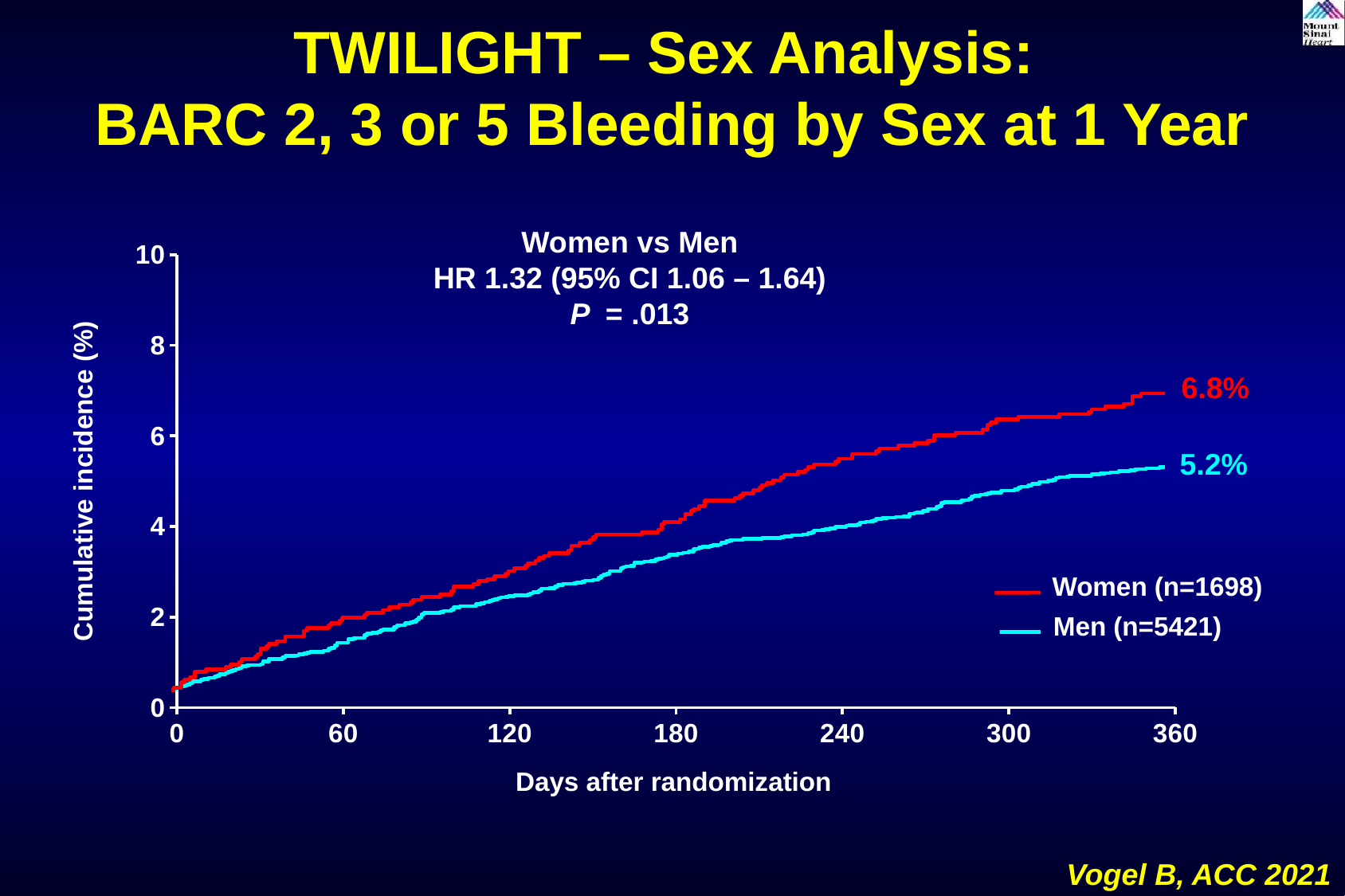
What is the cumulative incidence of BARC 2, 3 or 5 bleeding for Women at 1 year? 6.8% What kind of chart is shown on the slide? Line chart Which group has the higher cumulative incidence of bleeding at 1 year, Women or Men? Women Is the cumulative incidence for Men at day 180 greater or less than 4? less How many series does the legend list? 2 What is the difference in cumulative incidence at 1 year between Women and Men? 1.6% Do the cumulative incidence curves rise or fall as days after randomization increase? Rise What is the label of the x axis? Days after randomization What is the hazard ratio for Women vs Men shown on the chart? 1.32 What is the cumulative incidence of BARC 2, 3 or 5 bleeding for Men at 1 year? 5.2% Is the cumulative incidence for Women at day 300 greater or less than 6? greater How many patients are in the Men group according to the legend? 5421